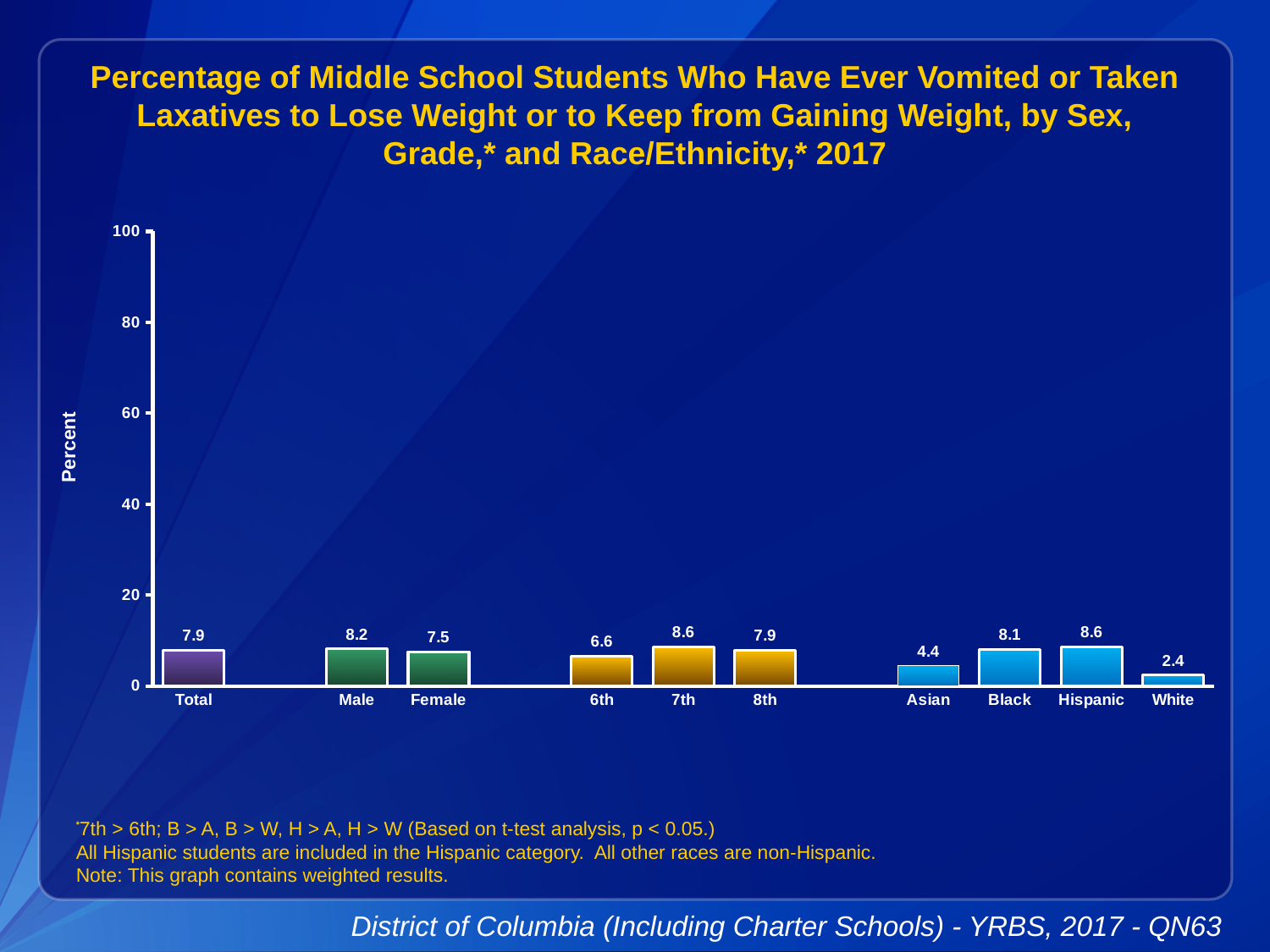
What is the difference between the values for Male and Female? 0.7 What is the difference between the values for Hispanic and White? 6.2 What is the value for Asian? 4.4 What is the value for Total? 7.9 What is the label of the y axis? Percent What kind of chart is this? bar chart Which grade has the highest value? 7th How many categories are shown on the x axis? 10 Which category has the lowest value? White Is the value for Black greater or less than 20? less Which is larger, the value for 6th or the value for 8th? 8th What is the value for Female? 7.5